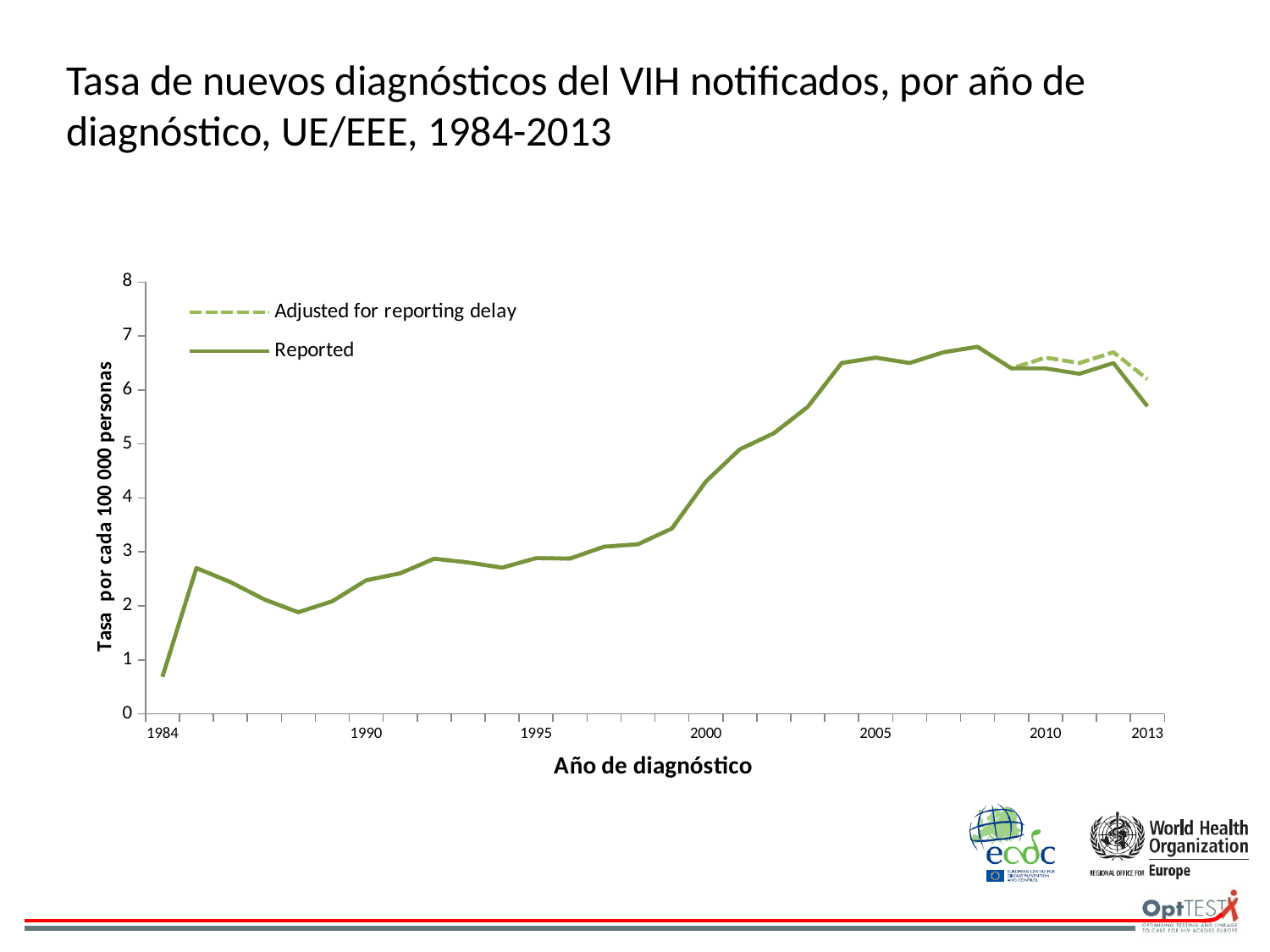
Is the Reported value for 2000 greater or less than 4? greater What kind of chart is shown on the slide? line chart In which year is the Reported rate lowest? 1984 Is the Reported value for 2013 greater or less than 5? greater Is the Reported value for 1990 greater or less than 3? less Which series is drawn with a dashed line? Adjusted for reporting delay In which year does the Reported rate reach its highest point? 2008 How many series does the legend list? 2 What is the title of the x axis? Año de diagnóstico Does the Reported rate generally rise or fall between 1999 and 2004? rise Which year has the higher Reported rate, 1995 or 2005? 2005